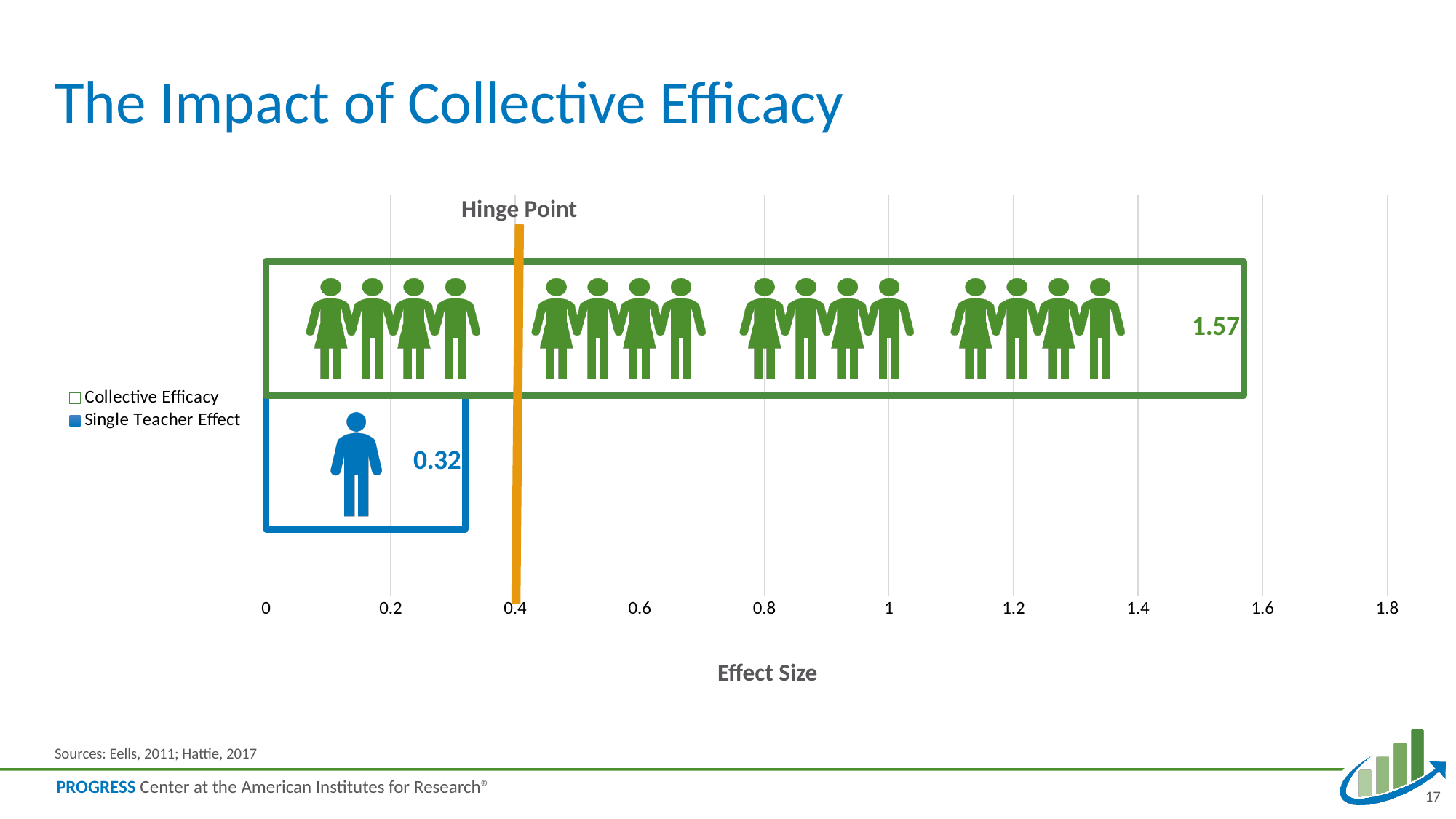
Which series has the smallest effect size? Single Teacher Effect Is the effect size for Collective Efficacy greater or less than 1.4? greater At what x-axis value is the Hinge Point line drawn? 0.4 What is the difference between the Collective Efficacy effect size and the Single Teacher Effect effect size? 1.25 What is the effect size for Single Teacher Effect? 0.32 How many series does the legend list? 2 What is the maximum value shown on the x axis? 1.8 What is the effect size for Collective Efficacy? 1.57 Is the effect size for Single Teacher Effect greater or less than 0.4? less What kind of chart is shown on the slide? Bar chart Which series has the larger effect size, Collective Efficacy or Single Teacher Effect? Collective Efficacy What is the label of the x axis? Effect Size